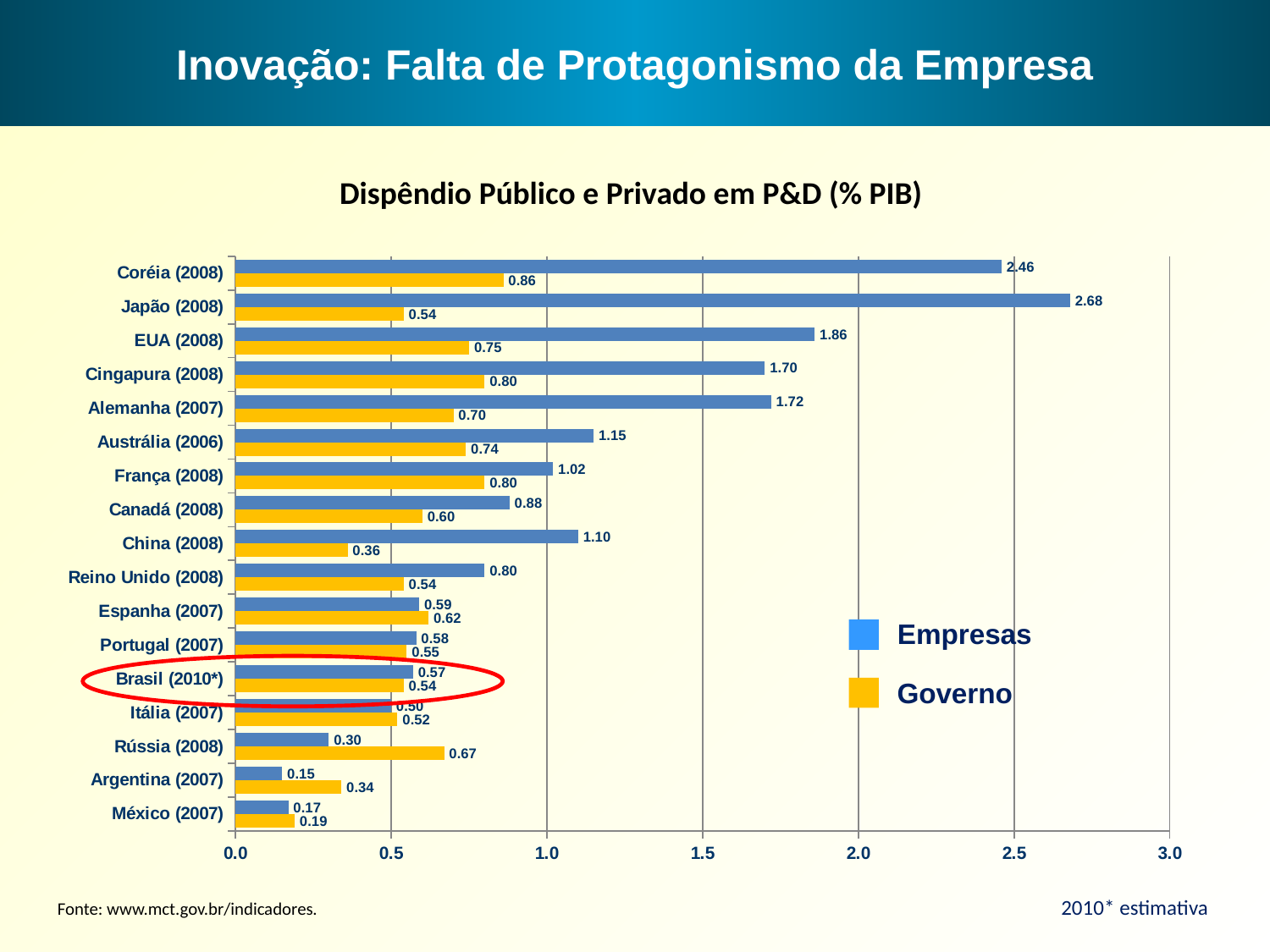
How many series does the legend list? 2 Which country has the lowest Governo value? México (2007) Which country has the highest Empresas value? Japão (2008) Is the Empresas value for EUA (2008) greater or less than 1.5? greater Which is larger for Rússia (2008): the Empresas value or the Governo value? Governo What is the Empresas value for Brasil (2010*)? 0.57 What kind of chart is shown on the slide? Bar chart What is the Governo value for Coréia (2008)? 0.86 How many countries are shown on the chart? 17 What is the Governo value for Rússia (2008)? 0.67 What is the difference between the Empresas and Governo values for China (2008)? 0.74 What is the title of the chart? Dispêndio Público e Privado em P&D (% PIB)